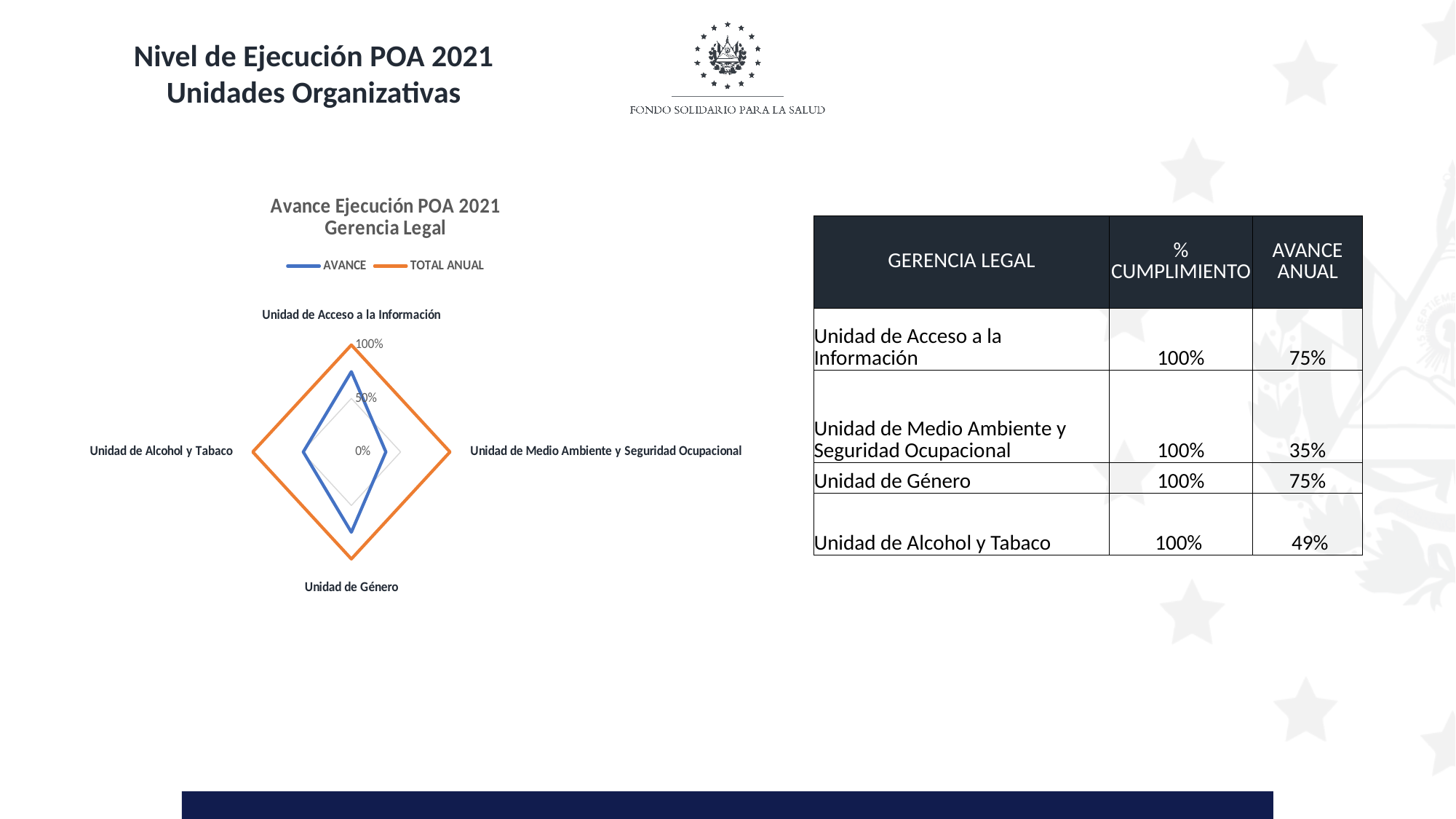
What are the two series named in the legend of the radar chart? AVANCE and TOTAL ANUAL Which has a larger AVANCE value: Unidad de Alcohol y Tabaco or Unidad de Medio Ambiente y Seguridad Ocupacional? Unidad de Alcohol y Tabaco How many series does the legend of the radar chart list? 2 What is the difference between the AVANCE values for Unidad de Acceso a la Información and Unidad de Medio Ambiente y Seguridad Ocupacional? 40 percentage points How many categories (axes) does the radar chart have? 4 Which category has the lowest AVANCE value? Unidad de Medio Ambiente y Seguridad Ocupacional What is the TOTAL ANUAL value for Unidad de Género? 100% What kind of chart is shown on the slide? Radar chart What is the AVANCE value for Unidad de Medio Ambiente y Seguridad Ocupacional? 35% Is the AVANCE value for Unidad de Acceso a la Información greater or less than 50%? greater What is the AVANCE value for Unidad de Alcohol y Tabaco? 49% What is the title of the radar chart? Avance Ejecución POA 2021 Gerencia Legal